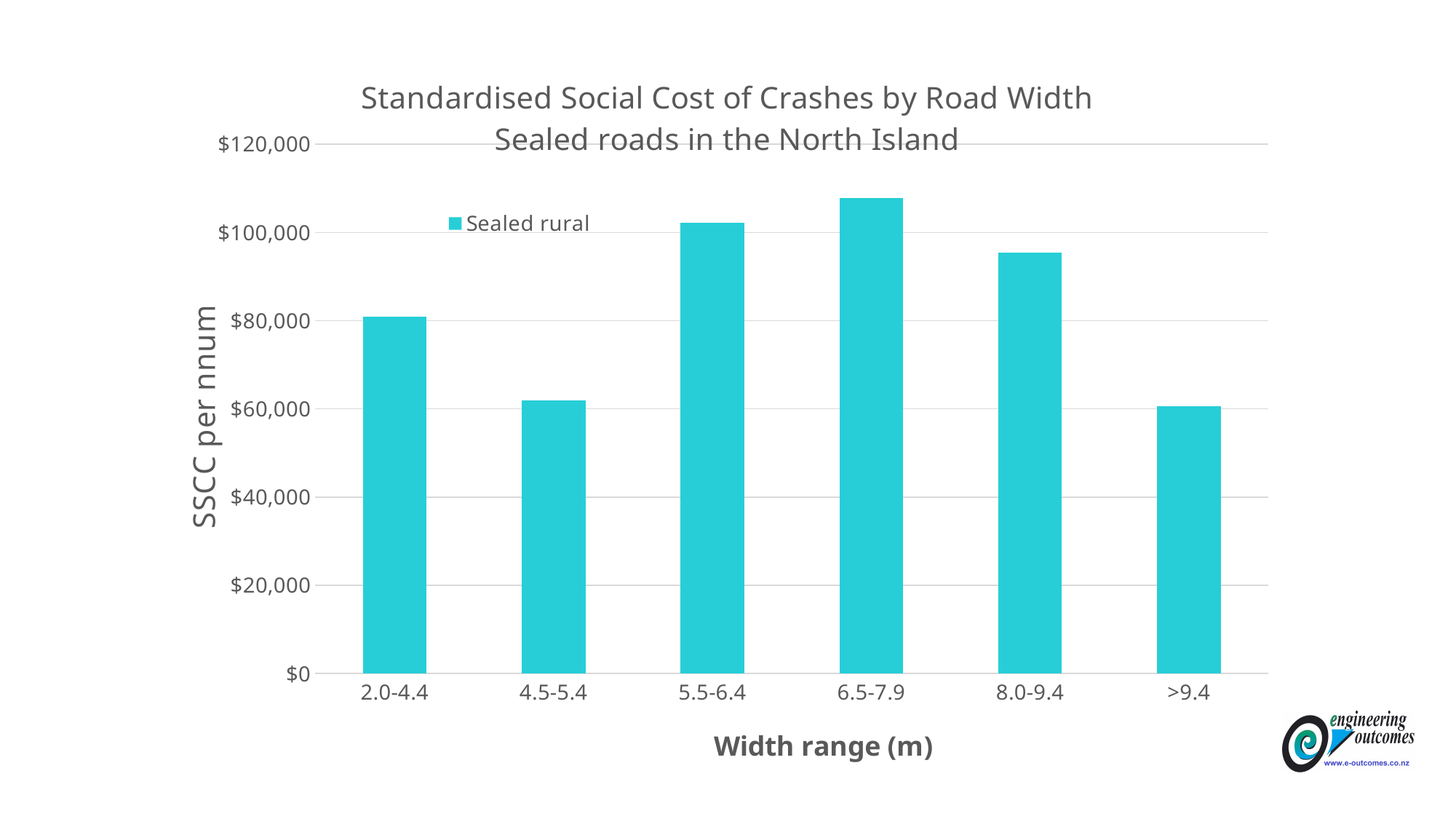
How many width range categories are shown on the x axis? 6 Which has the higher SSCC per annum, the 2.0-4.4 width range or the 4.5-5.4 width range? 2.0-4.4 How many series does the legend list? 1 Is the value for the 5.5-6.4 width range greater or less than $100,000? greater What type of chart is shown on the slide? bar chart Which has the higher SSCC per annum, the 8.0-9.4 width range or the >9.4 width range? 8.0-9.4 What is the name of the series shown in the legend? Sealed rural Is the value for the >9.4 width range greater or less than $40,000? greater Which width range has the highest SSCC per annum? 6.5-7.9 Is the value for the 8.0-9.4 width range greater or less than $100,000? less